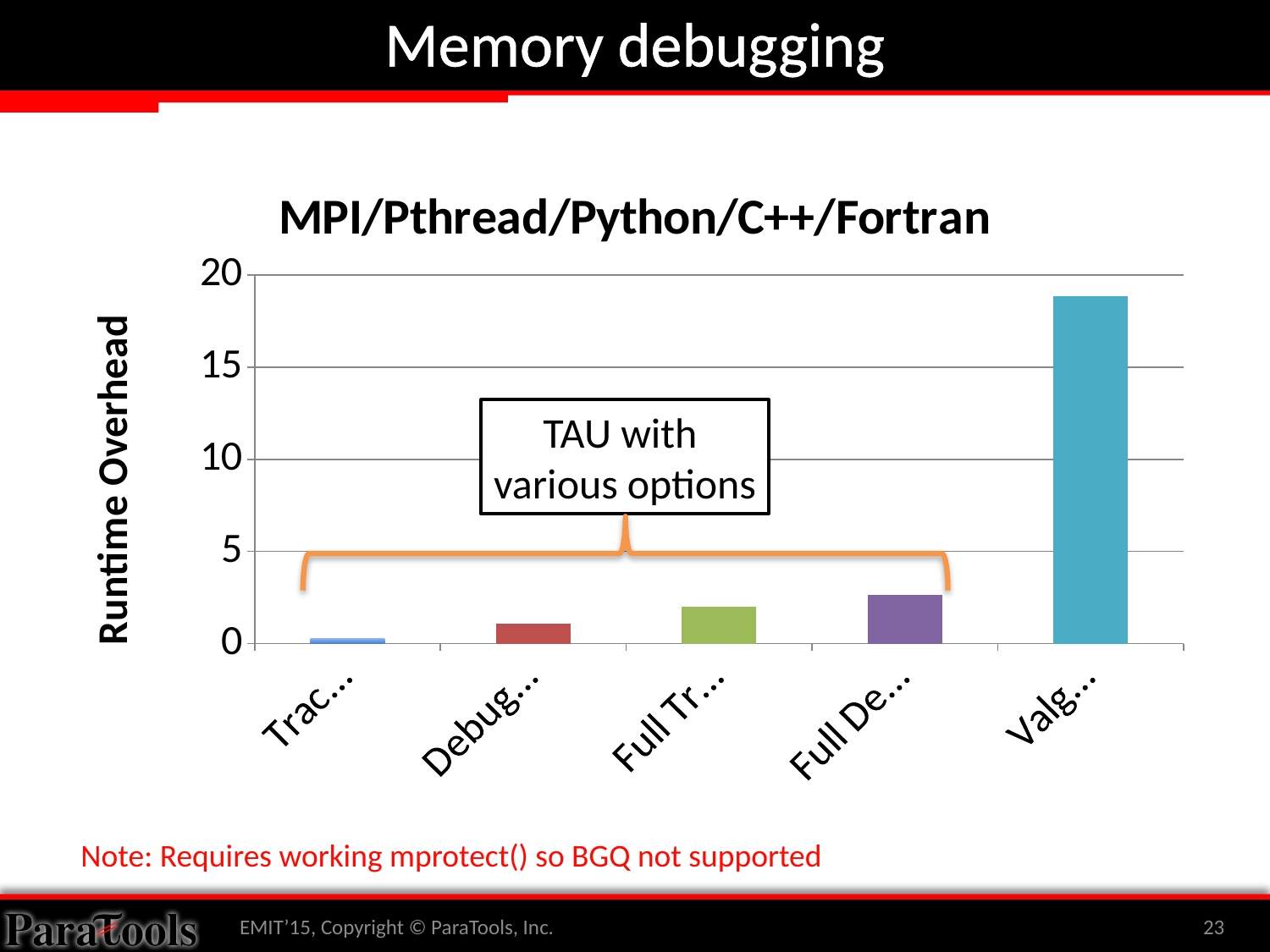
Which is larger, the value for Full Tr… or the value for Debug…? Full Tr… What kind of chart is shown on the slide? bar chart How many bars (categories) are plotted in the chart? 5 Do the bar values rise or fall from left to right along the x axis? rise What is the label on the vertical axis of the chart? Runtime Overhead Is the value for Full De… greater or less than 5? less Which category has the highest runtime overhead? Valg… Is the value for Debug… greater or less than 5? less Which category has the lowest runtime overhead? Trac… What is the title of the chart? MPI/Pthread/Python/C++/Fortran Is the value for Valg… greater or less than 15? greater Which is larger, the value for Valg… or the value for Full De…? Valg…